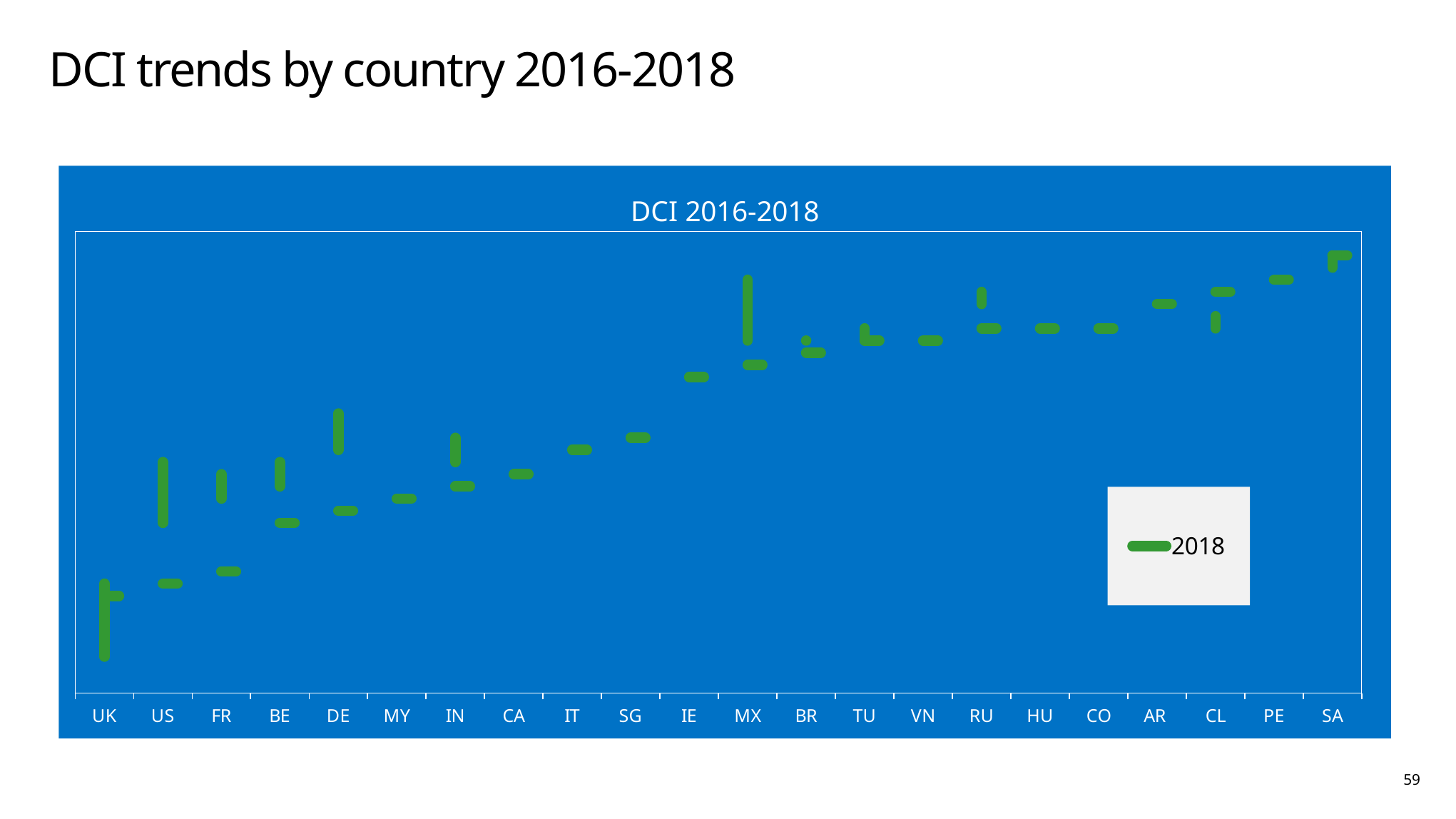
What is the series name shown in the chart's legend? 2018 Is the 2018 marker for IE higher or lower than the 2018 marker for CA? higher How many countries are shown on the x axis of the chart? 22 Which has the higher 2018 marker, MX or IT? MX Which has the higher 2018 marker, PE or HU? PE Do the 2018 markers generally rise or fall moving from left to right along the x axis? rise Which country has the highest 2018 marker in the chart? SA How many series does the chart's legend list? 1 Which country has the lowest 2018 marker in the chart? UK Which country is the first category on the x axis? UK What is the title of the chart on the slide? DCI 2016-2018